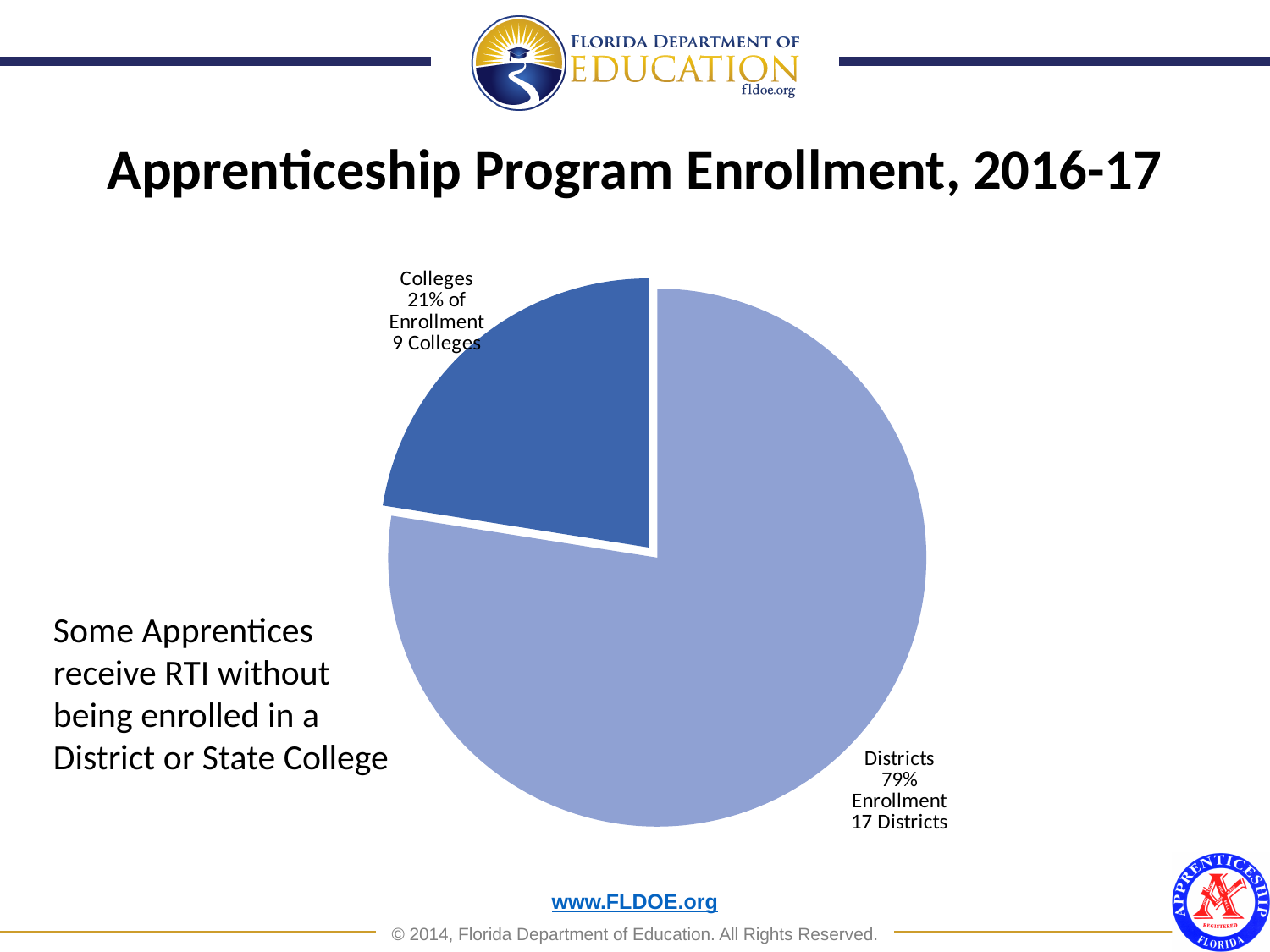
What is the difference in percentage points between the Districts share and the Colleges share? 58 Which is larger, the Districts share or the Colleges share of enrollment? Districts Which slice is shown in the darker blue colour? Colleges What is the title of the chart? Apprenticeship Program Enrollment, 2016-17 What share of enrollment do Districts account for? 79% How many colleges are represented in the Colleges slice? 9 Colleges Which slice of the pie is the largest? Districts What kind of chart is shown on the slide? pie chart How many districts are represented in the Districts slice? 17 Districts Which slice of the pie is the smallest? Colleges What share of enrollment do Colleges account for? 21% How many slices does the pie chart have? 2